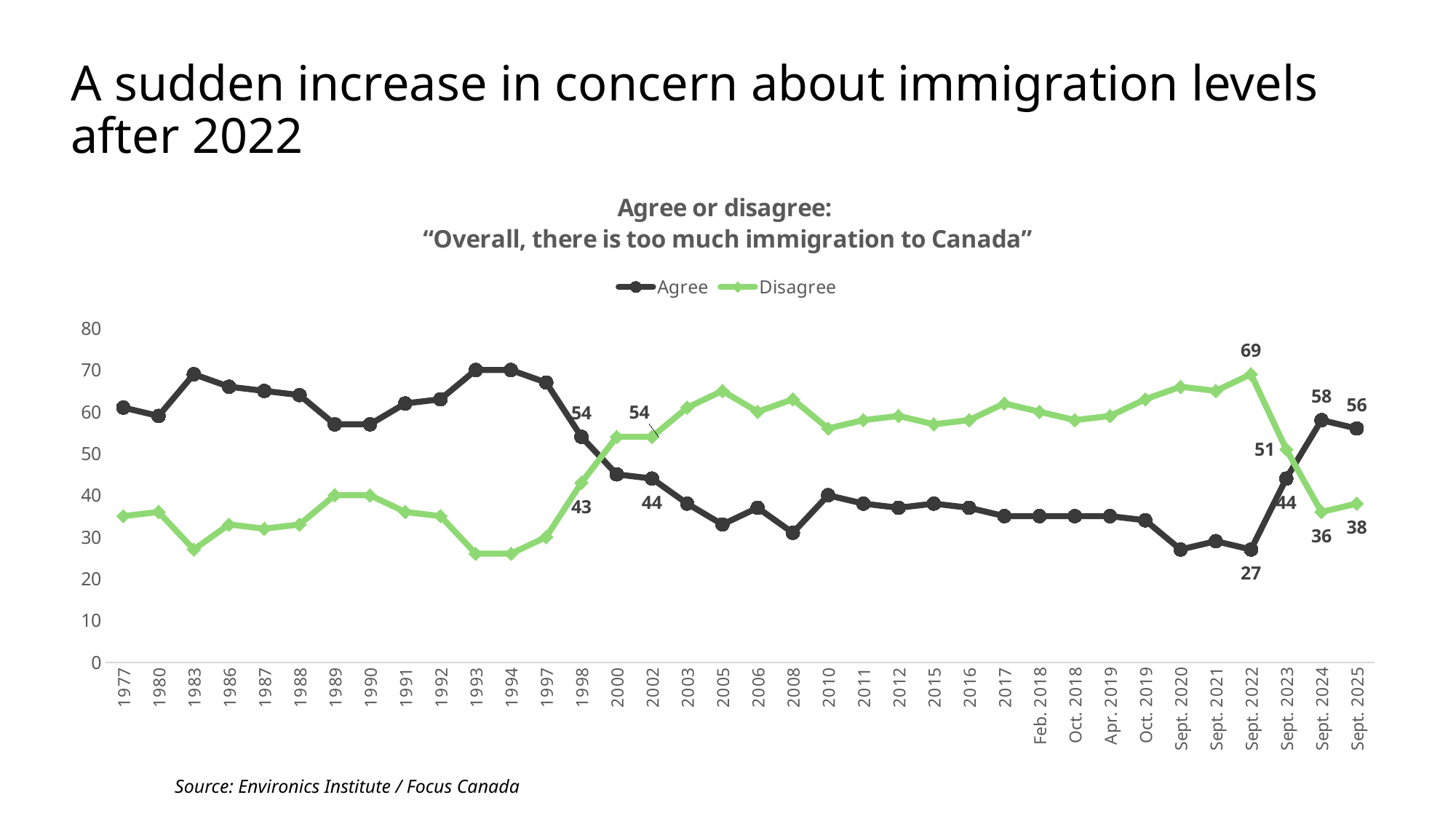
Is the Agree value for 1983 greater or less than 60? greater What is the Disagree value for Sept. 2022? 69 What is the Agree value for Sept. 2022? 27 In Sept. 2022, how much higher is the Disagree value than the Agree value? 42 By how much did the Agree value change between Sept. 2024 and Sept. 2025? 2 In Sept. 2023, which is larger: Agree or Disagree? Disagree Is the Disagree value for 1993 greater or less than 30? less What is the Disagree value for Sept. 2025? 38 In which period does the Disagree series reach its highest value? Sept. 2022 What is the Agree value for Sept. 2024? 58 What kind of chart is shown on the slide? line chart How many series does the legend list? 2